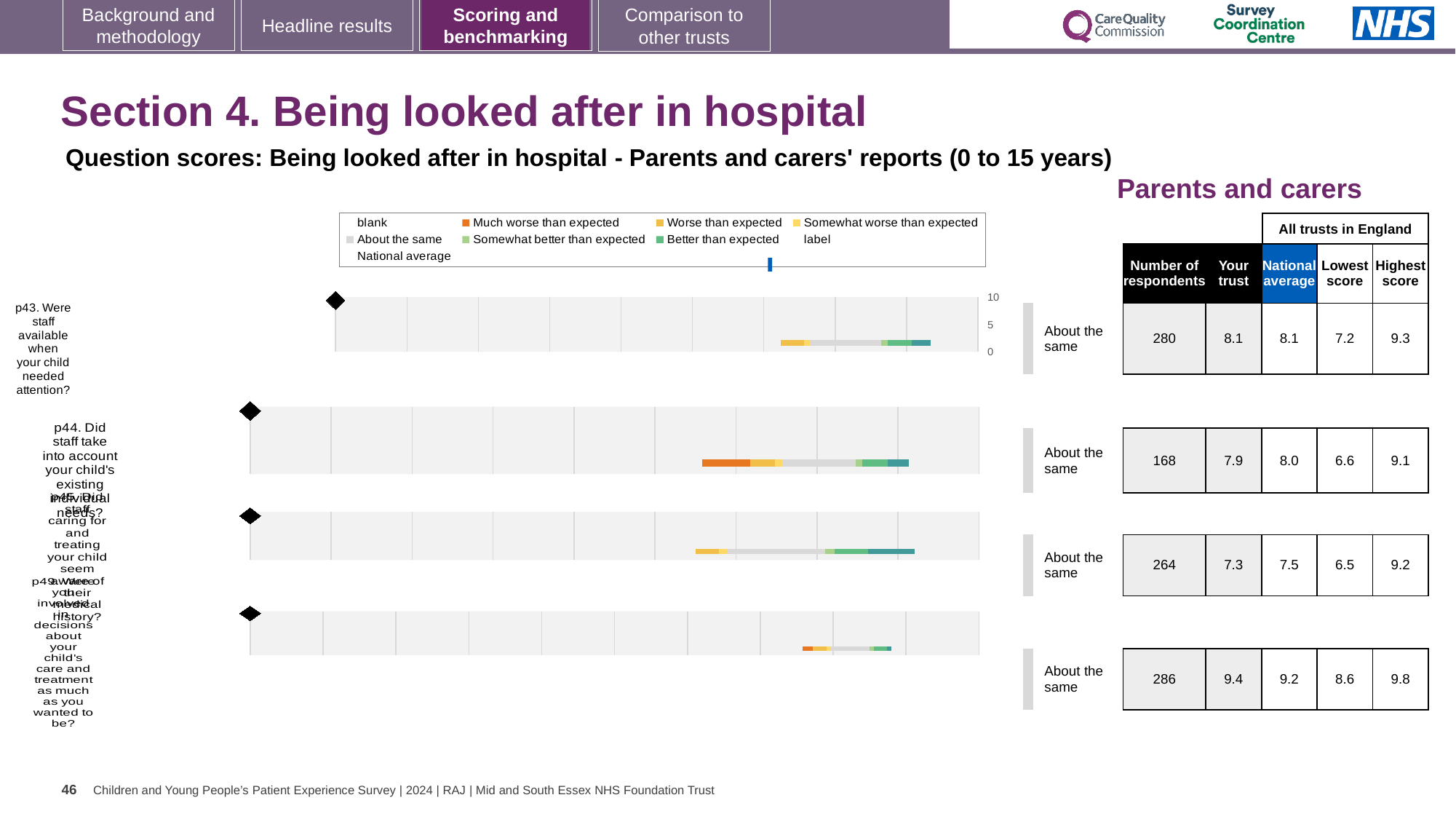
What is the benchmark category shown next to the chart for p43 (Were staff available when your child needed attention?)? About the same Which of the four questions has the highest 'Your trust' score in the table beside the charts? p49 In the table beside the charts, what is the 'Your trust' score for p43 (Were staff available when your child needed attention?)? 8.1 In the chart legend, which colour represents 'Much worse than expected'? orange For p49, what is the difference between the 'Your trust' score (9.4) and the national average (9.2)? 0.2 For p45, which is larger: the 'Your trust' score or the national average? National average In the table beside the charts, what is the highest score for p49 (Were you involved in decisions about your child's care and treatment as much as you wanted to be?)? 9.8 Which of the four questions has the lowest 'Your trust' score in the table beside the charts? p45 What kind of chart is used to show the benchmarking results for each question on this slide? bar chart In the table beside the charts, what is the national average for p45 (Did staff caring for and treating your child seem aware of their medical history?)? 7.5 In the table beside the charts, how many respondents are listed for p44 (Did staff take into account your child's existing individual needs?)? 168 How many survey questions (rows) are plotted in the benchmarking charts on this slide? 4